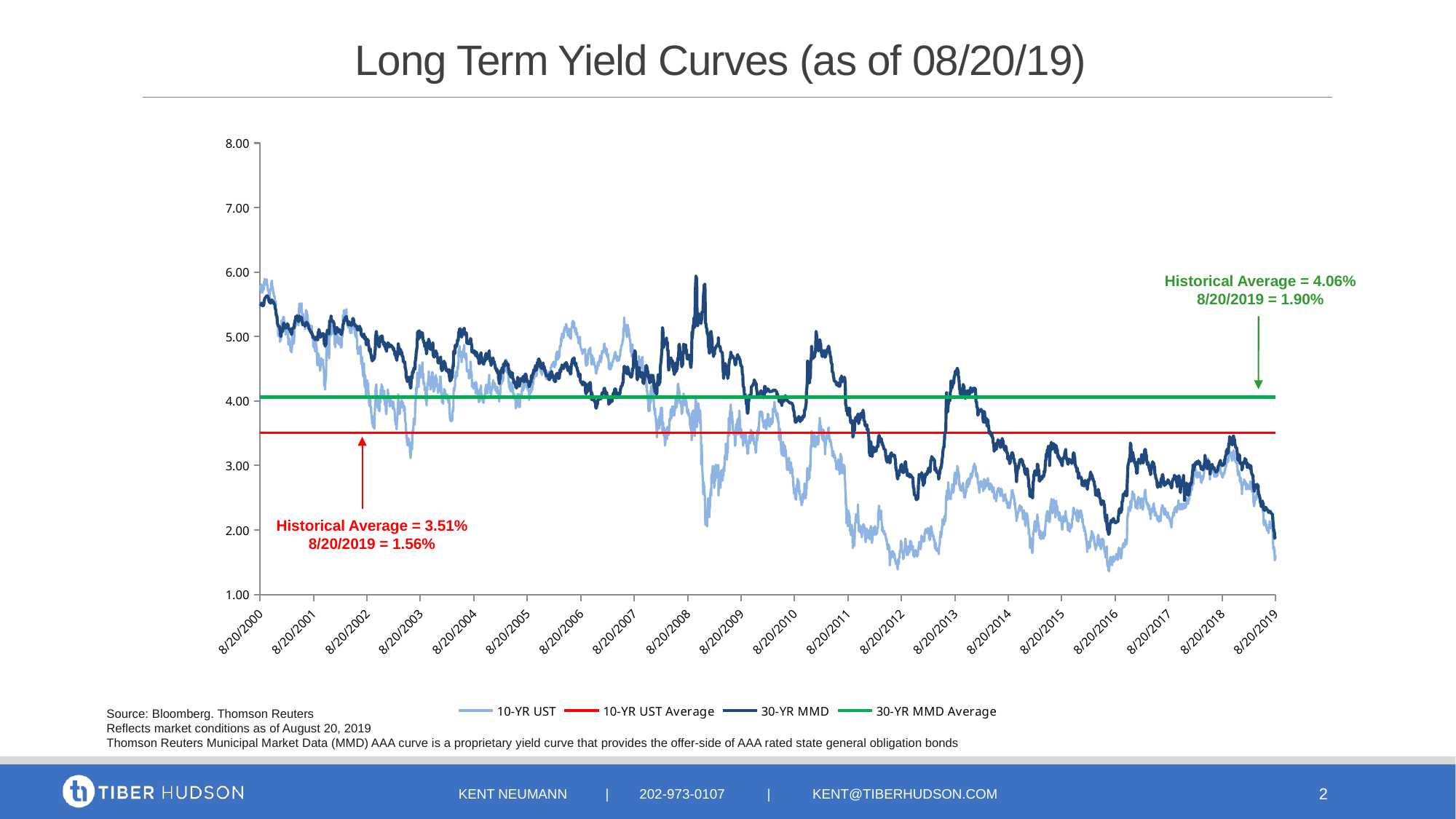
Is the 30-YR MMD value at 8/20/2000 greater or less than 5.00? greater What is the 10-YR UST value on 8/20/2019? 1.56% What is the historical average for the 10-YR UST series? 3.51% What is the 30-YR MMD value on 8/20/2019? 1.90% What is the historical average for the 30-YR MMD series? 4.06% On 8/20/2019, how much higher is the 30-YR MMD value than the 10-YR UST value? 0.34% What colour is the 30-YR MMD Average line? Green What is the difference between the 30-YR MMD historical average and the 10-YR UST historical average? 0.55% Which series has the higher historical average, 10-YR UST or 30-YR MMD? 30-YR MMD What type of chart is shown on the slide? Line chart How many series does the legend list? 4 Overall, does the 10-YR UST series rise or fall from 8/20/2000 to 8/20/2019? Fall